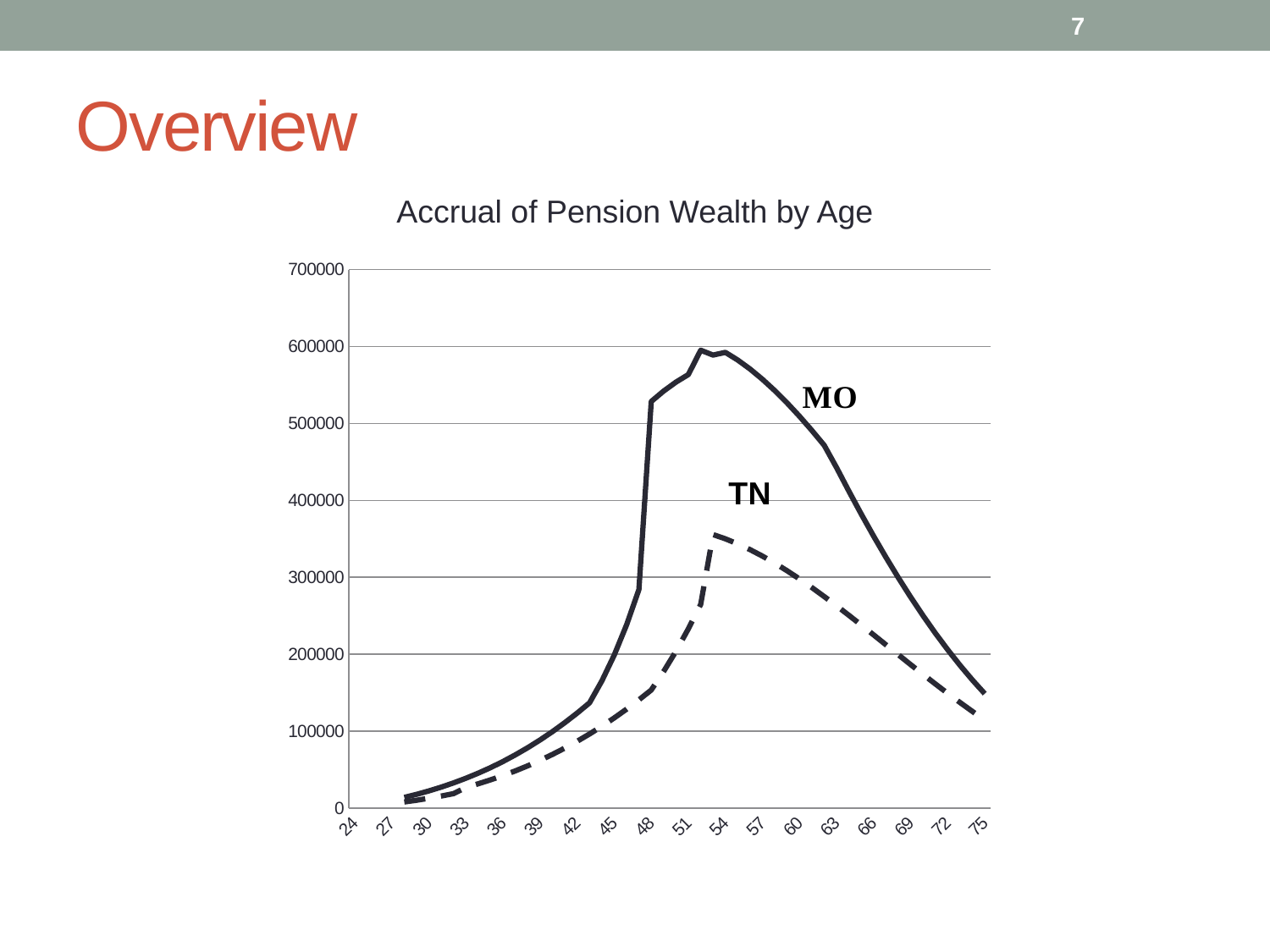
What kind of chart is shown on the slide? line chart Does the MO series rise or fall between age 57 and age 75? fall Is the value for TN at age 54 greater or less than 400000? less Which series reaches the higher peak value, MO or TN? MO Which series is drawn with a dashed line? TN Is the value for MO at age 75 greater or less than 200000? less Is the value for TN at age 63 greater or less than 300000? less At age 60, which series has the larger value, MO or TN? MO How many age ticks are labelled on the x axis? 18 What is the title of the chart? Accrual of Pension Wealth by Age How many series are plotted on the chart? 2